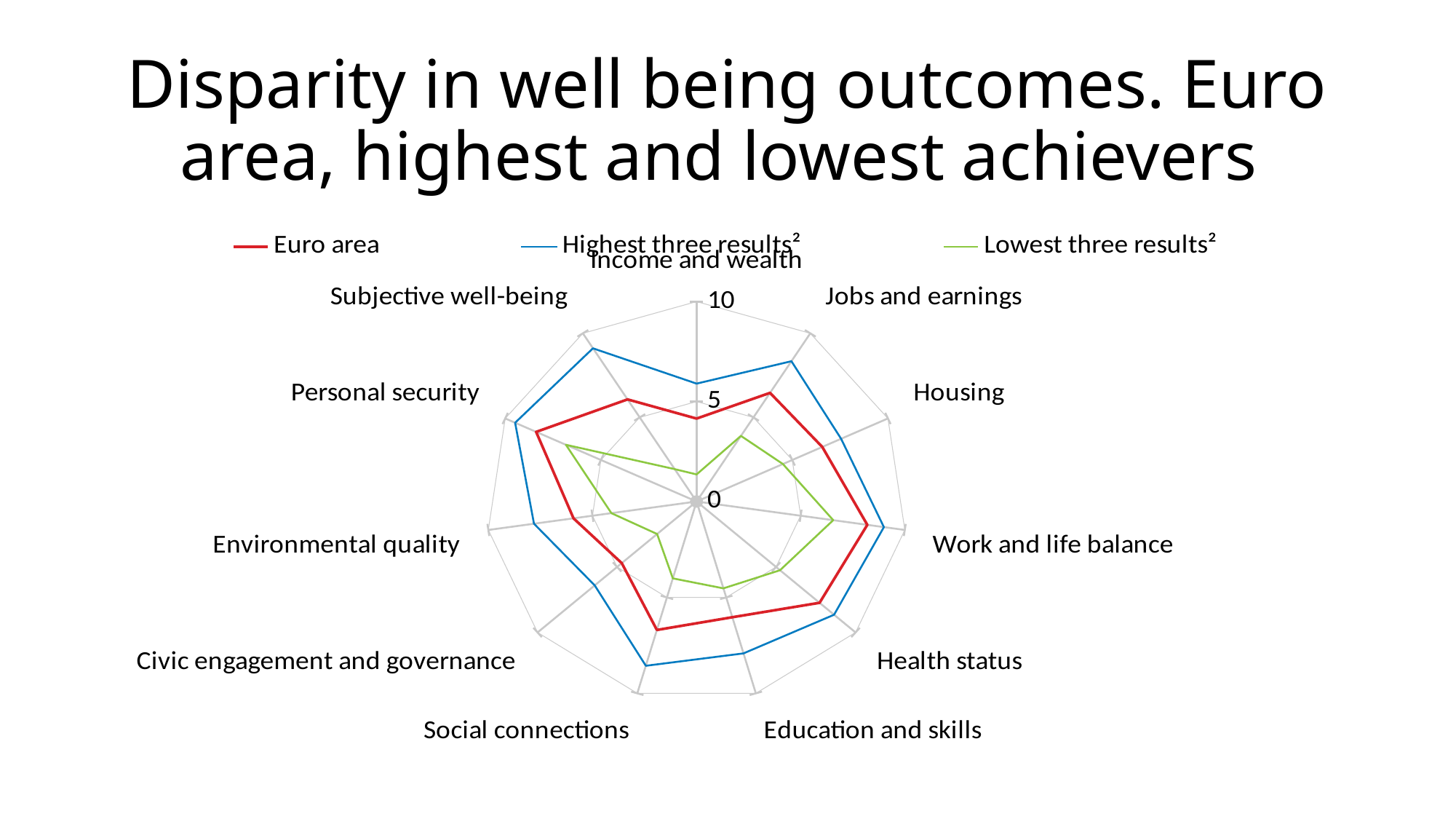
What kind of chart is shown on the slide? Radar chart For Work and life balance, which series has the larger value: Euro area or Lowest three results? Euro area Which series is plotted in red? Euro area Is the Euro area value for Work and life balance greater or less than 5? greater Is the Lowest three results value for Income and wealth greater or less than 5? less Is the Highest three results value for Social connections greater or less than 5? greater For Personal security, which series has the larger value: Euro area or Highest three results? Highest three results How many series does the legend list? 3 For the Lowest three results series, which category has the lowest value? Income and wealth How many categories (axes) does the radar chart have? 11